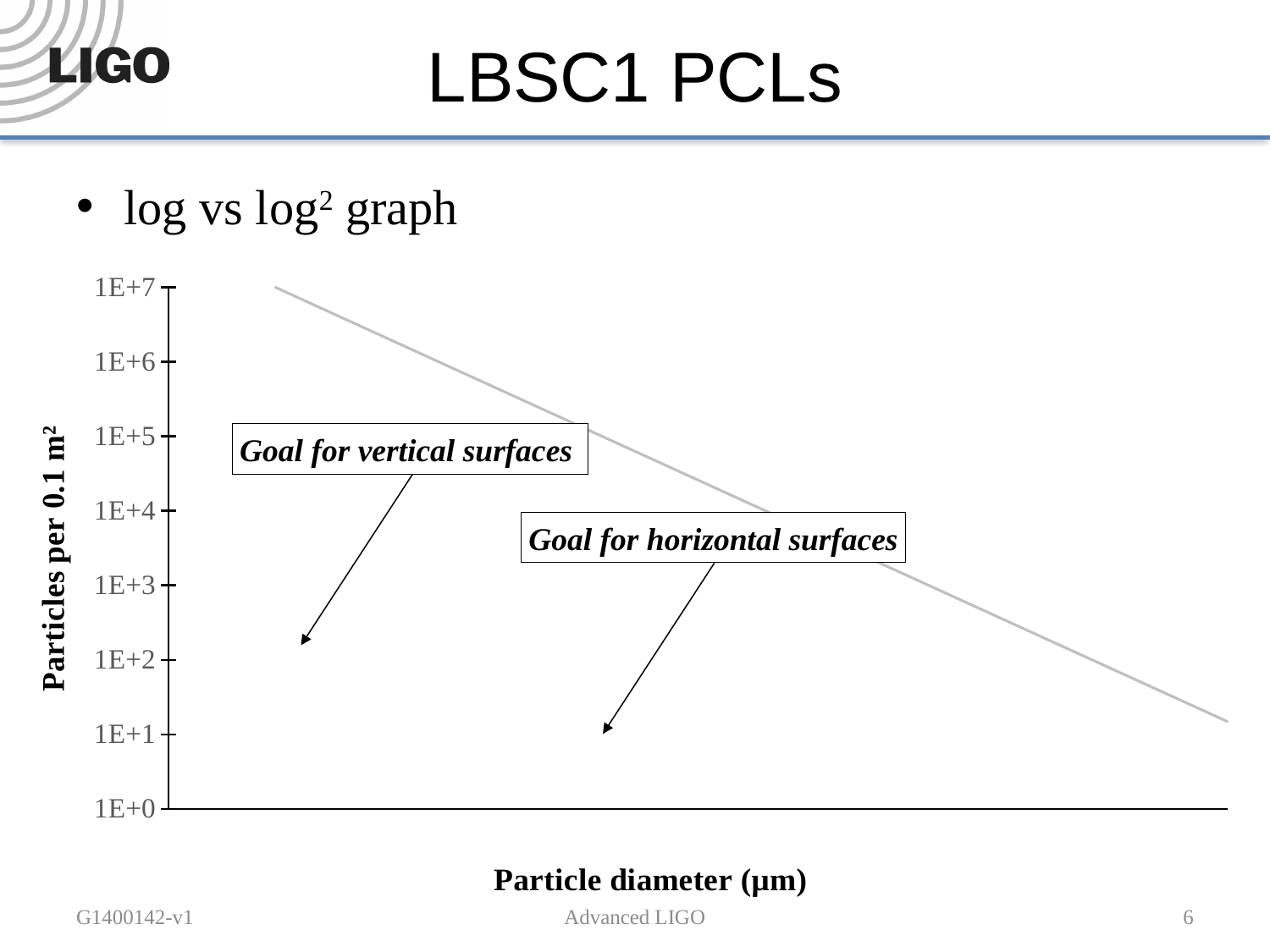
At the right end of the plotted line, is the value greater or less than 1E+2? less How many lines are plotted on the chart? 1 At the left end of the plotted line, is the value greater or less than 1E+6? greater Does the plotted line rise or fall as particle diameter increases along the x axis? fall What kind of chart is shown on the slide? line chart How many tick labels are shown on the y axis? 8 What is the label of the y axis? Particles per 0.1 m² What is the lowest tick value shown on the y axis? 1E+0 What is the highest tick value shown on the y axis? 1E+7 What is the label of the x axis? Particle diameter (µm)